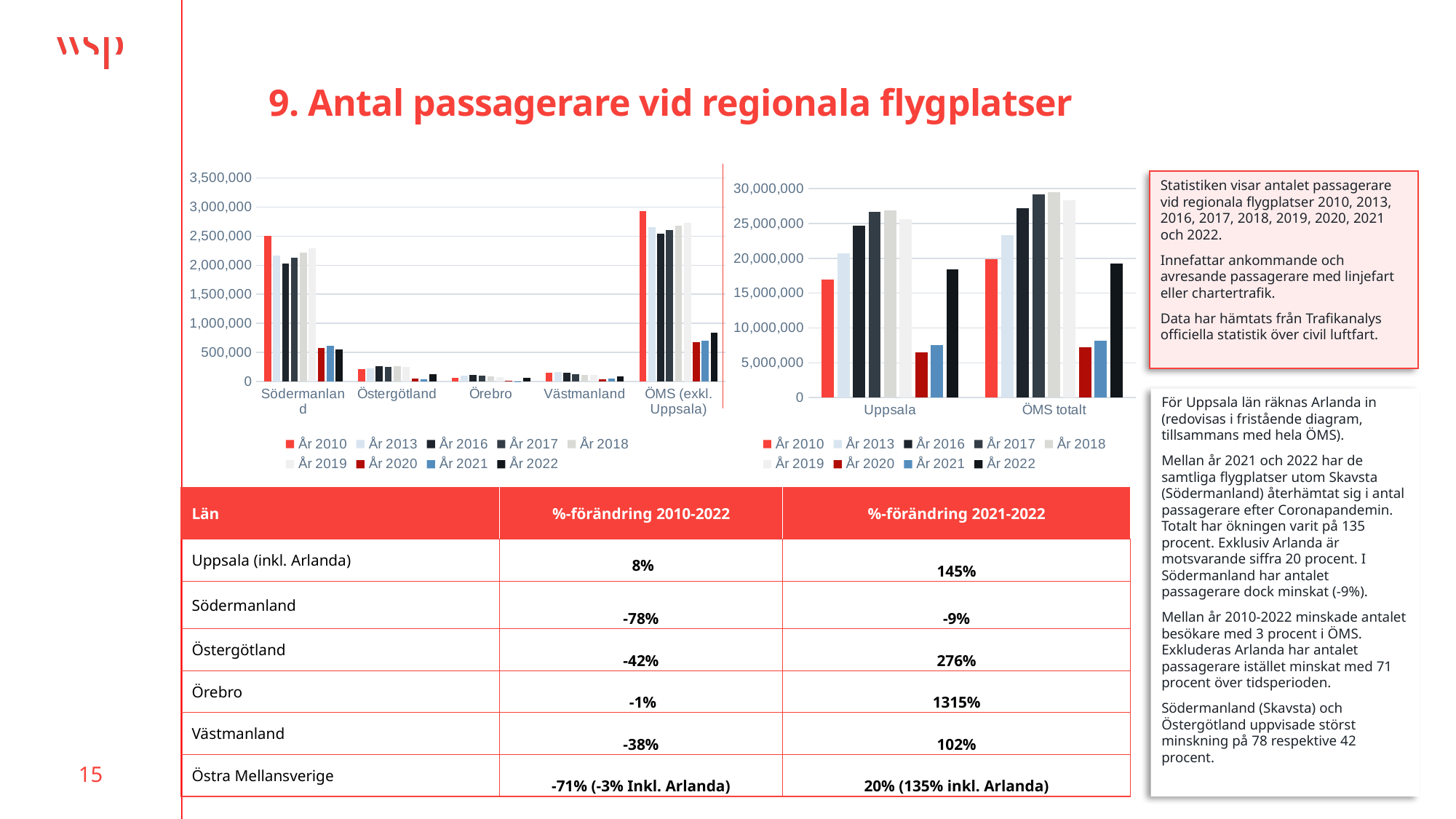
In the left chart, which is larger in År 2010: Södermanland or Östergötland? Södermanland In the left chart, is the value for Södermanland in År 2020 greater or less than 1,000,000? less How many categories are shown on the x axis of the right chart (Uppsala / ÖMS totalt)? 2 In the left chart, is the value for Södermanland in År 2010 greater or less than 2,000,000? greater How many categories are shown on the x axis of the left chart? 5 In the left chart, which category has the lowest bars overall? Örebro In the left chart, is the value for ÖMS (exkl. Uppsala) in År 2010 greater or less than 2,500,000? greater What kind of chart is the left chart on the slide? Bar chart How many series does the legend of the left chart list? 9 In the right chart, which is larger for Uppsala: the value for År 2021 or the value for År 2022? År 2022